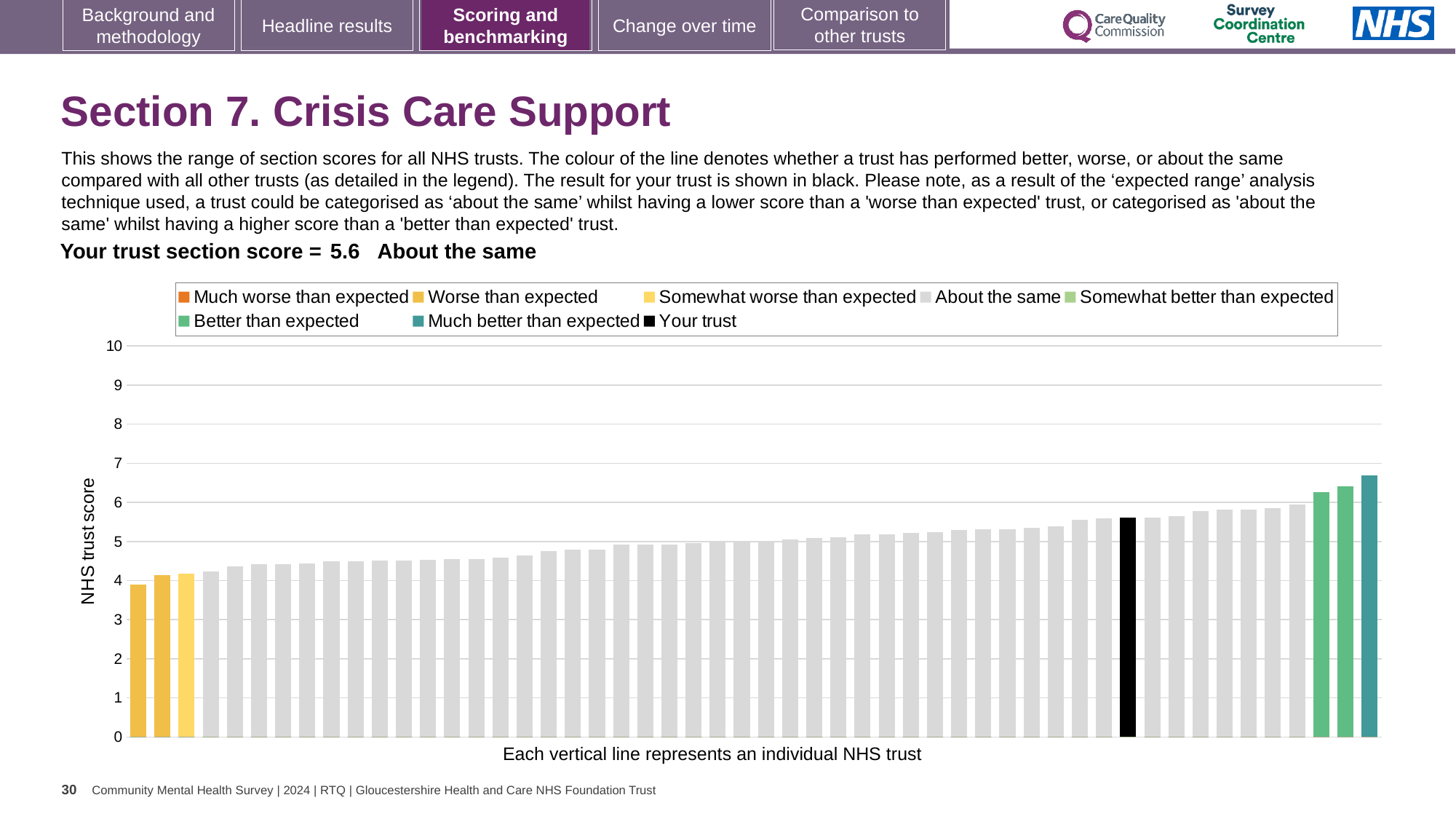
Is the lowest bar in the chart greater or less than 5? less What is the section score for your trust shown on the slide? 5.6 Is the highest bar in the chart greater or less than 6? greater Which legend category does the highest bar in the chart belong to? Much better than expected What is the label on the vertical axis of the chart? NHS trust score Is the value for your trust (the black bar) greater or less than 5? greater What colour is used for the bar representing your trust? black Which category is your trust placed in for this section? About the same Do the bar values rise or fall from left to right across the chart? rise How many entries does the chart legend list? 8 Is the black bar for your trust higher or lower than the rightmost bar? lower What kind of chart is shown on the slide? bar chart